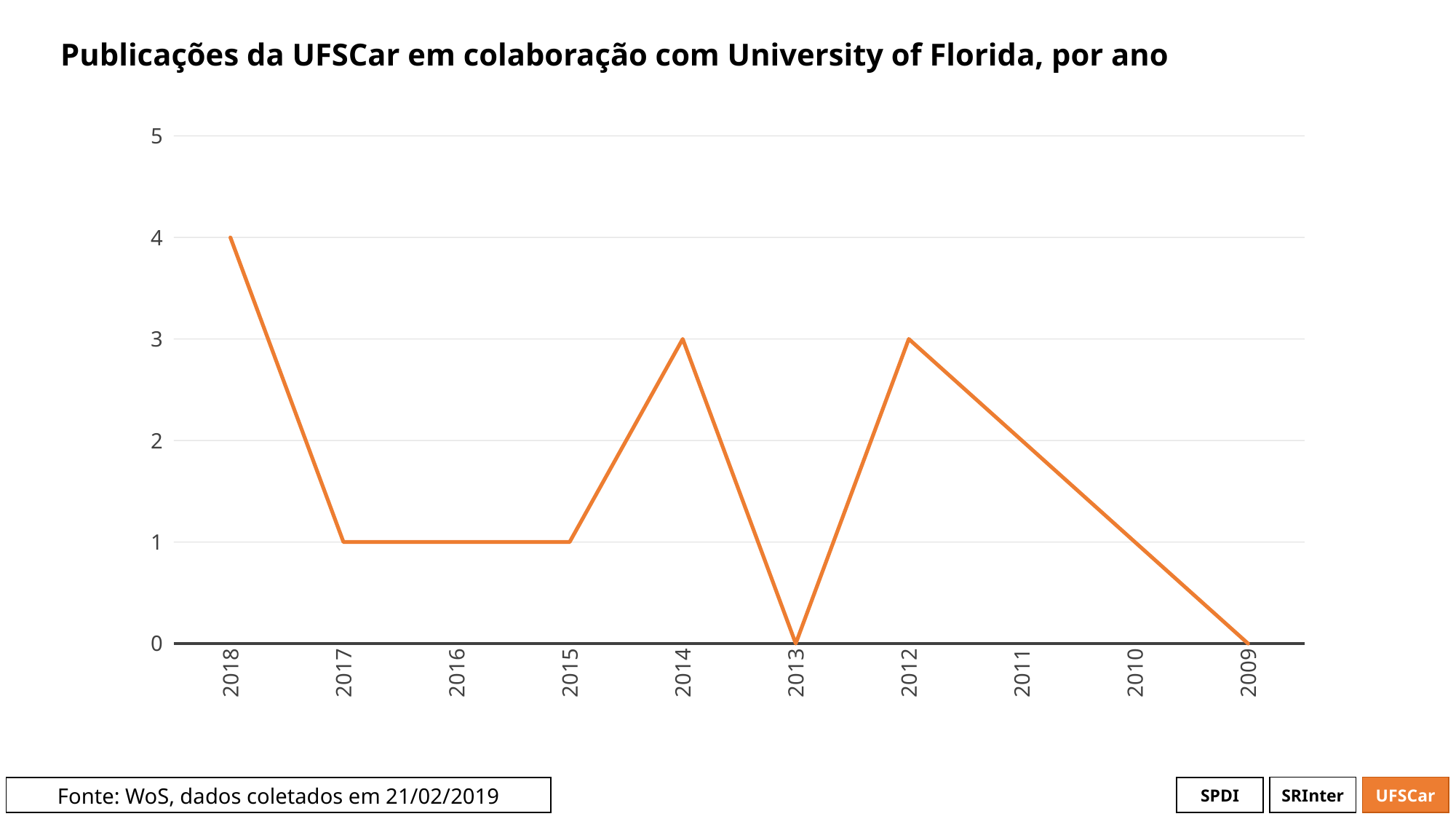
What is the value for 2017? 1 What is the title of the chart? Publicações da UFSCar em colaboração com University of Florida, por ano Which year has the highest value? 2018 What is the value for 2012? 3 How many years are shown on the x axis? 10 What kind of chart is shown on the slide? line chart Does the value rise or fall from 2018 to 2017? fall What is the value for 2014? 3 What is the value for 2013? 0 What is the difference between the values for 2018 and 2014? 1 What is the value for 2018? 4 Which is larger, the value for 2018 or the value for 2012? 2018